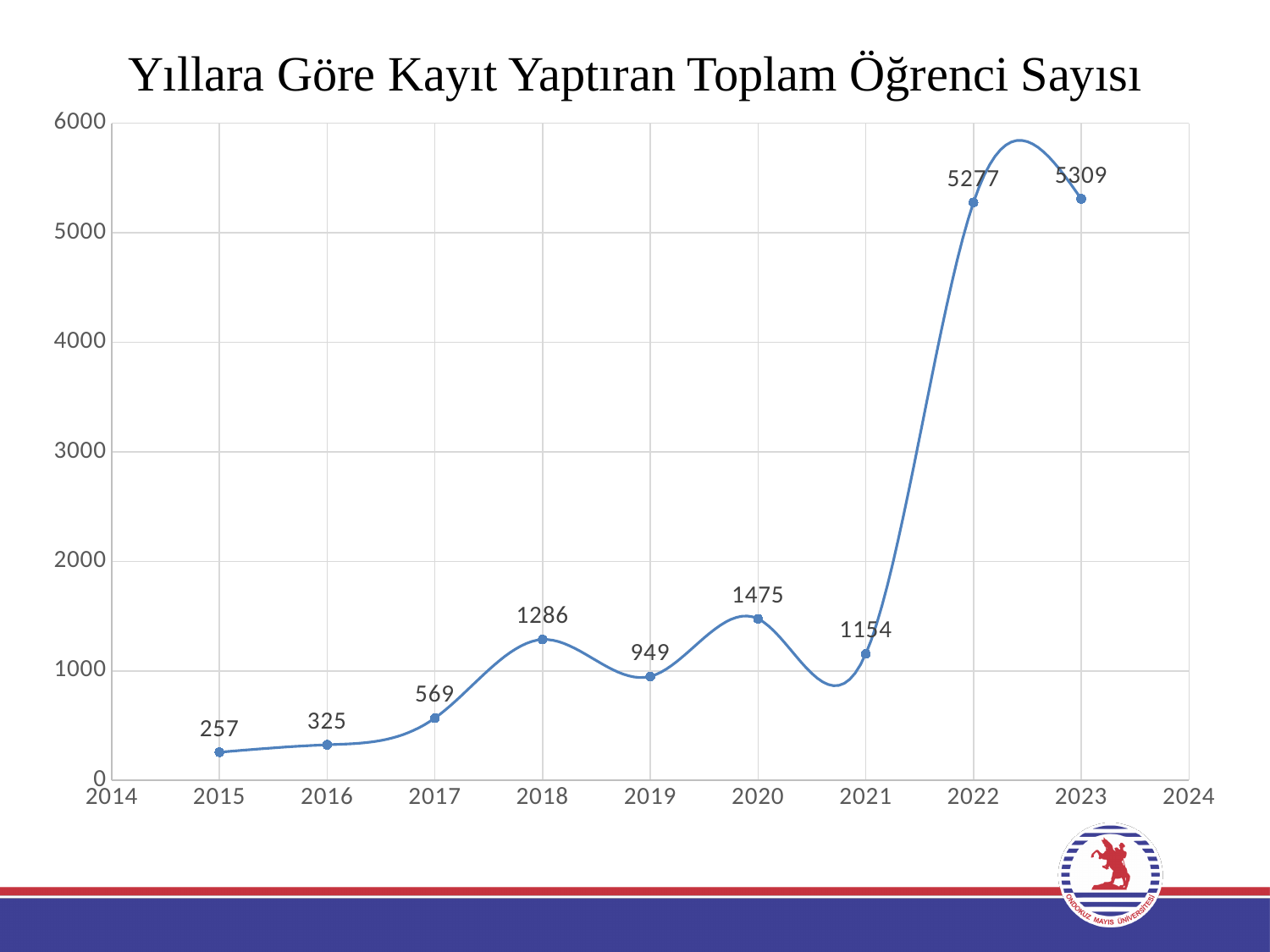
What is the value shown for 2015? 257 Is the value for 2022 greater or less than 5000? greater What is the value shown for 2021? 1154 Which year has the lowest number of registered students? 2015 How many data points are plotted on the chart? 9 What is the difference between the values for 2020 and 2019? 526 Which is larger, the value for 2018 or the value for 2020? 2020 What is the total number of registered students in 2018? 1286 Which year has the highest number of registered students? 2023 What kind of chart is shown on the slide? line chart What is the difference between the values for 2022 and 2021? 4123 What is the title of the chart? Yıllara Göre Kayıt Yaptıran Toplam Öğrenci Sayısı